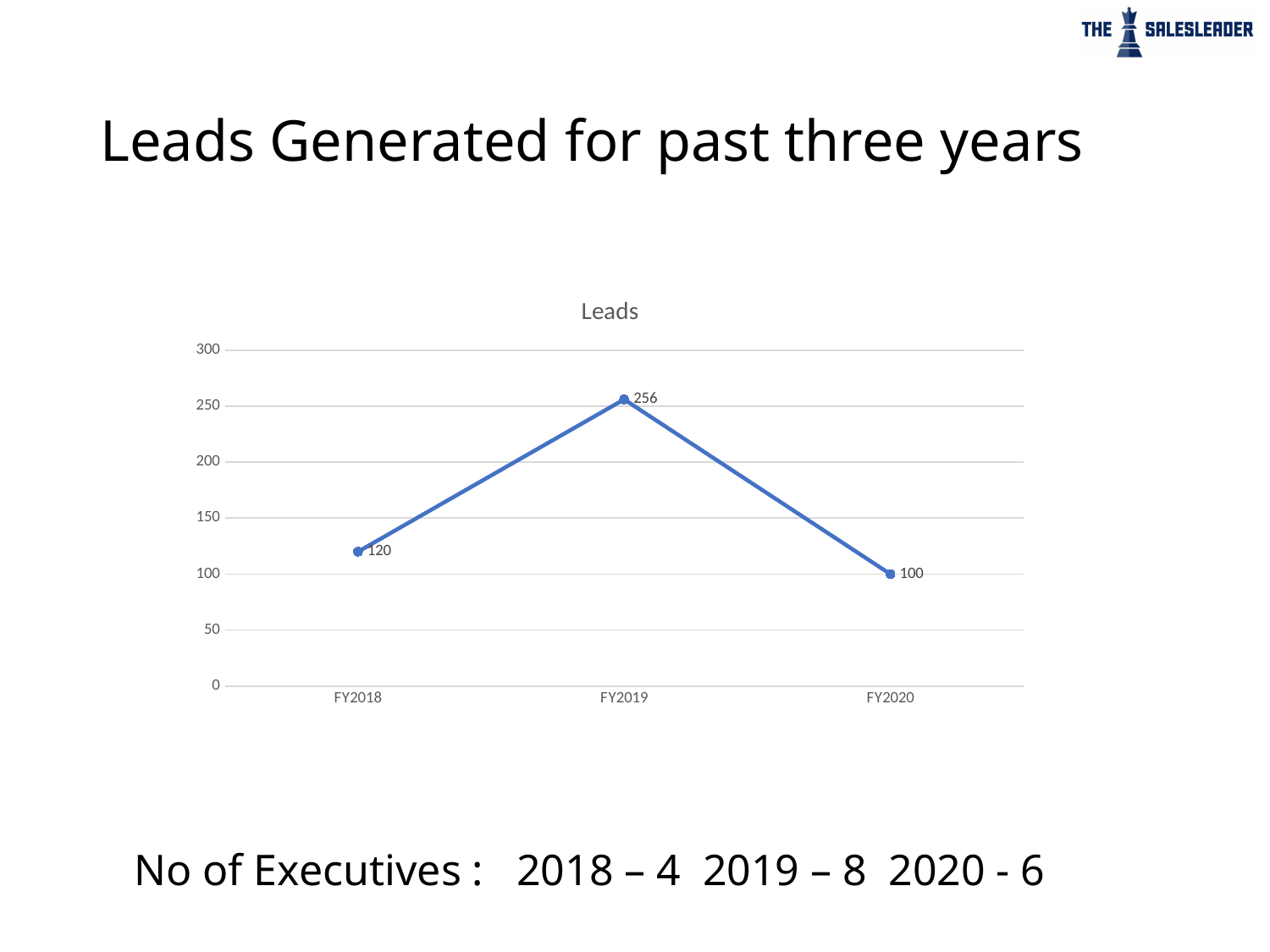
What is the value for FY2020 in the Leads chart? 100 What kind of chart is shown on the slide? line chart How many years are plotted in the Leads chart? 3 Which year has the highest number of leads? FY2019 Is the value for FY2019 greater or less than 200? greater What is the difference between the leads in FY2019 and FY2018? 136 What is the value for FY2019 in the Leads chart? 256 What is the title of the chart? Leads Which year has the lowest number of leads? FY2020 What is the difference between the leads in FY2018 and FY2020? 20 What is the value for FY2018 in the Leads chart? 120 Which is larger, the leads for FY2018 or FY2020? FY2018